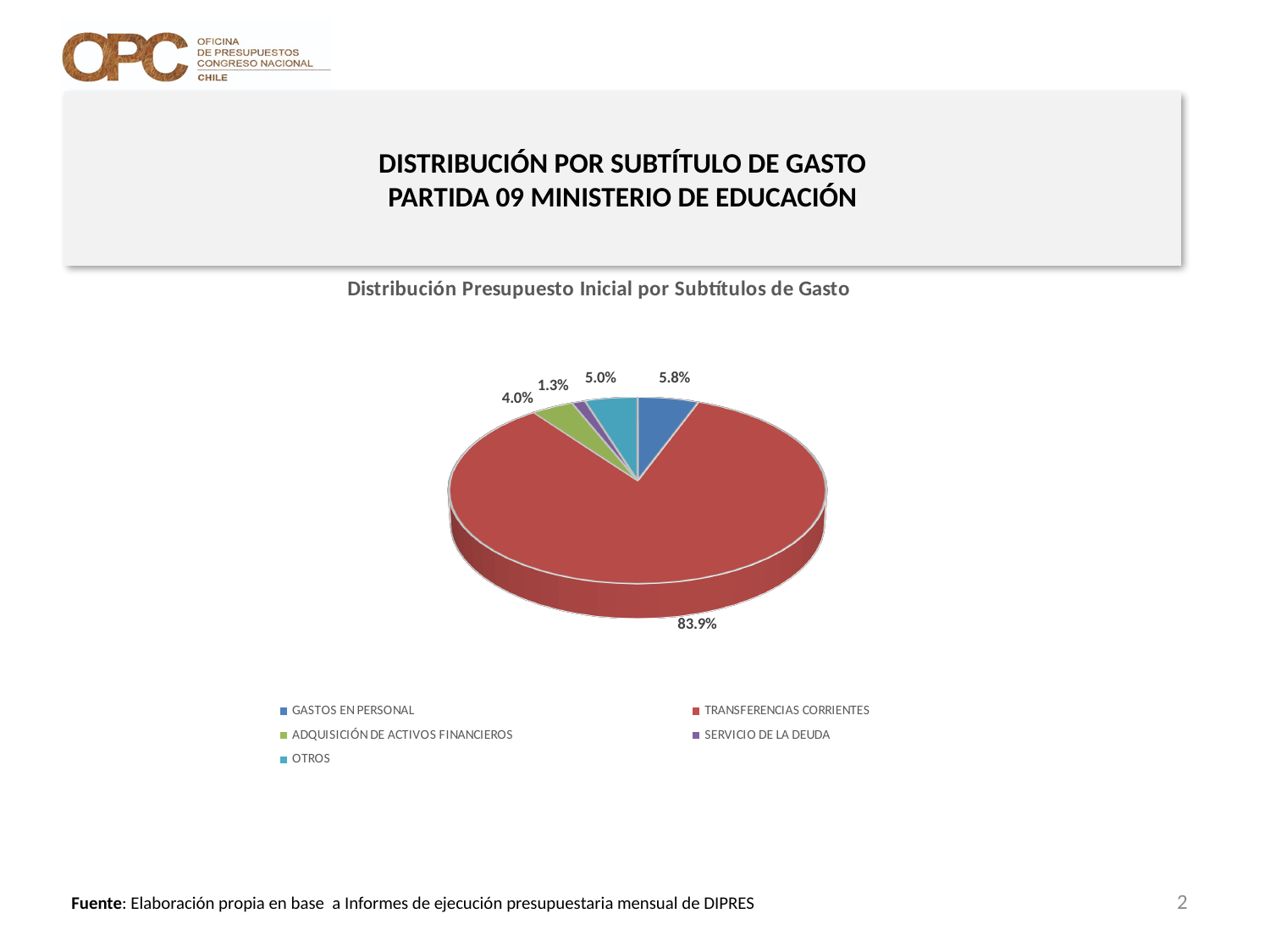
Which category has the smallest slice of the pie? SERVICIO DE LA DEUDA What share of the pie does GASTOS EN PERSONAL represent? 5.8% What share of the pie does TRANSFERENCIAS CORRIENTES represent? 83.9% What is the difference between the share for GASTOS EN PERSONAL and the share for ADQUISICIÓN DE ACTIVOS FINANCIEROS? 1.8% Which category has the largest slice of the pie? TRANSFERENCIAS CORRIENTES What share of the pie does ADQUISICIÓN DE ACTIVOS FINANCIEROS represent? 4.0% What is the title of the chart? Distribución Presupuesto Inicial por Subtítulos de Gasto How many categories does the legend list? 5 Which is larger, the share for GASTOS EN PERSONAL or the share for OTROS? GASTOS EN PERSONAL What kind of chart is shown on the slide? pie chart